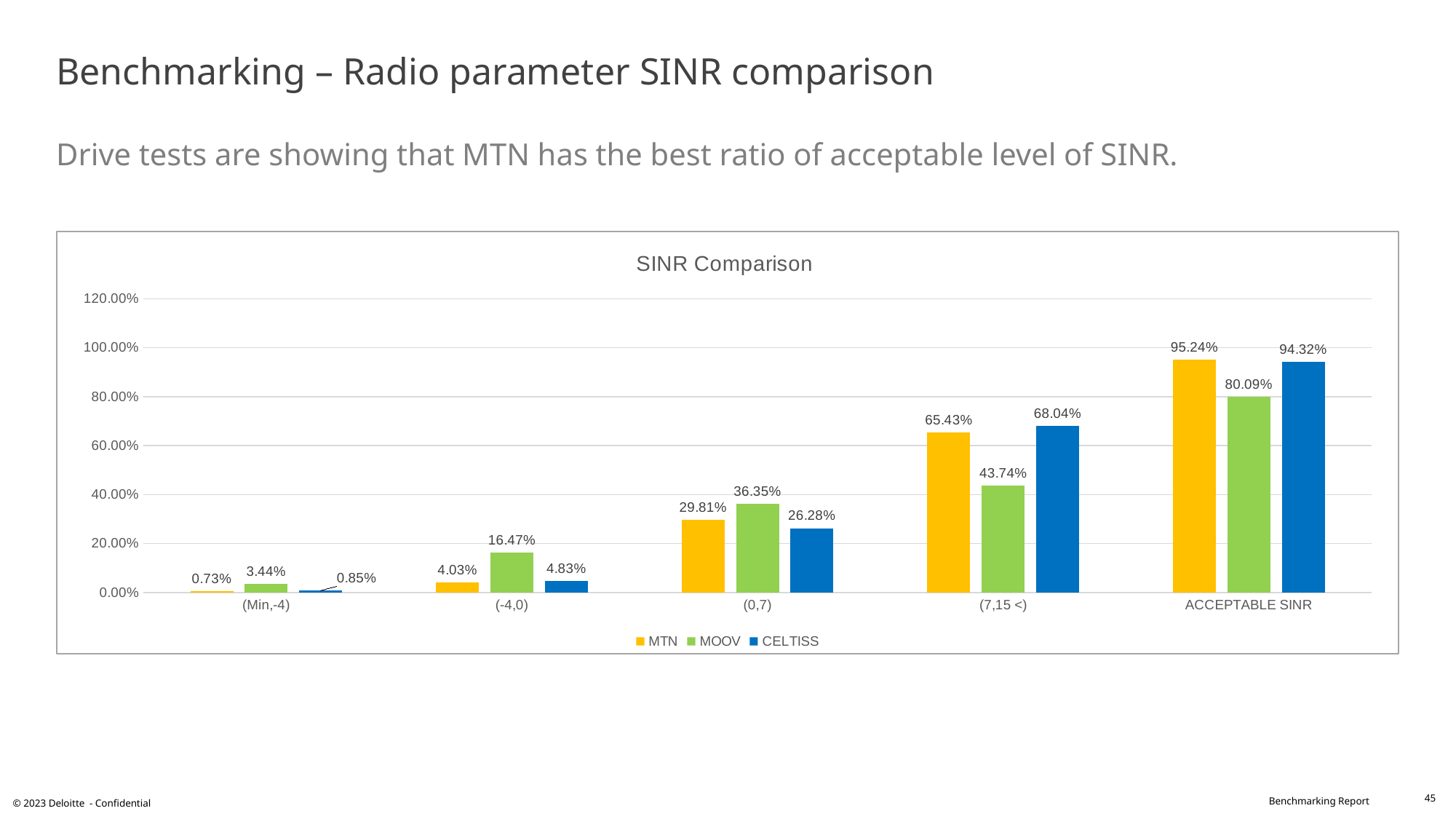
In the (0,7) category, which is larger: the MTN value or the MOOV value? MOOV What is the title of the chart? SINR Comparison What kind of chart is shown on the slide? Bar chart Is the value for MOOV in the (7,15 <) category greater or less than 40.00%? greater Which series has the highest value in the (7,15 <) category? CELTISS What is the difference between the MTN and MOOV values in the ACCEPTABLE SINR category? 15.15% Which series has the lowest value in the ACCEPTABLE SINR category? MOOV How many categories are shown on the x axis? 5 What is the value for CELTISS in the (0,7) category? 26.28% What is the value for MOOV in the (-4,0) category? 16.47% What is the value for MTN in the ACCEPTABLE SINR category? 95.24% How many series does the legend list? 3